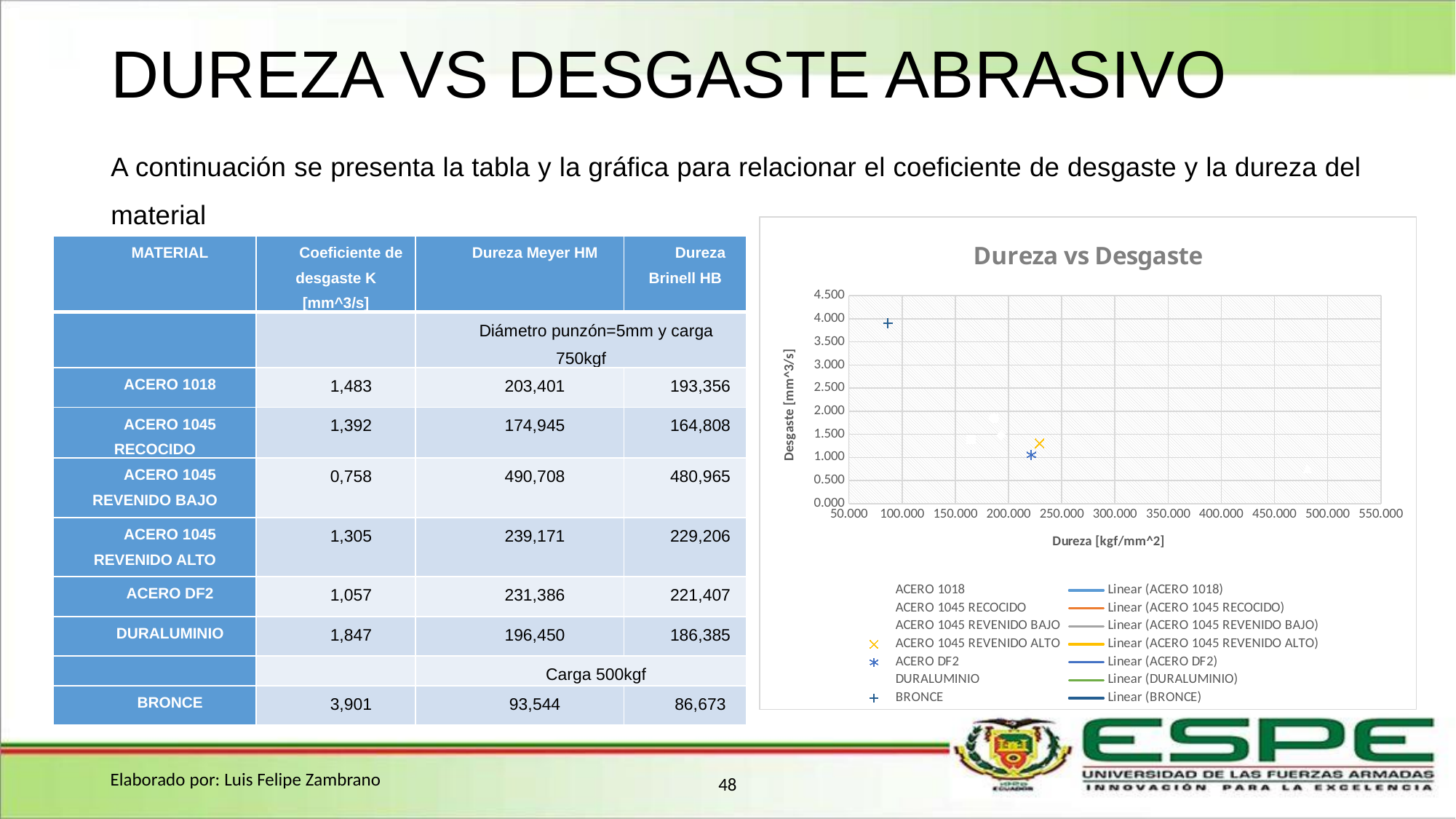
Is the Desgaste value for BRONCE greater or less than 3.500? greater Is the Desgaste value for ACERO 1045 REVENIDO ALTO greater or less than 2.000? less Is the Dureza value for BRONCE greater or less than 150.000? less What is the label of the vertical axis of the chart? Desgaste [mm^3/s] How many entries does the chart legend list? 14 Which plotted material has the highest Desgaste value in the chart? BRONCE Which has the larger Desgaste value in the chart, BRONCE or ACERO DF2? BRONCE What kind of chart is shown on the slide? scatter chart Which has the larger Dureza value in the chart, ACERO DF2 or BRONCE? ACERO DF2 What is the title of the chart? Dureza vs Desgaste